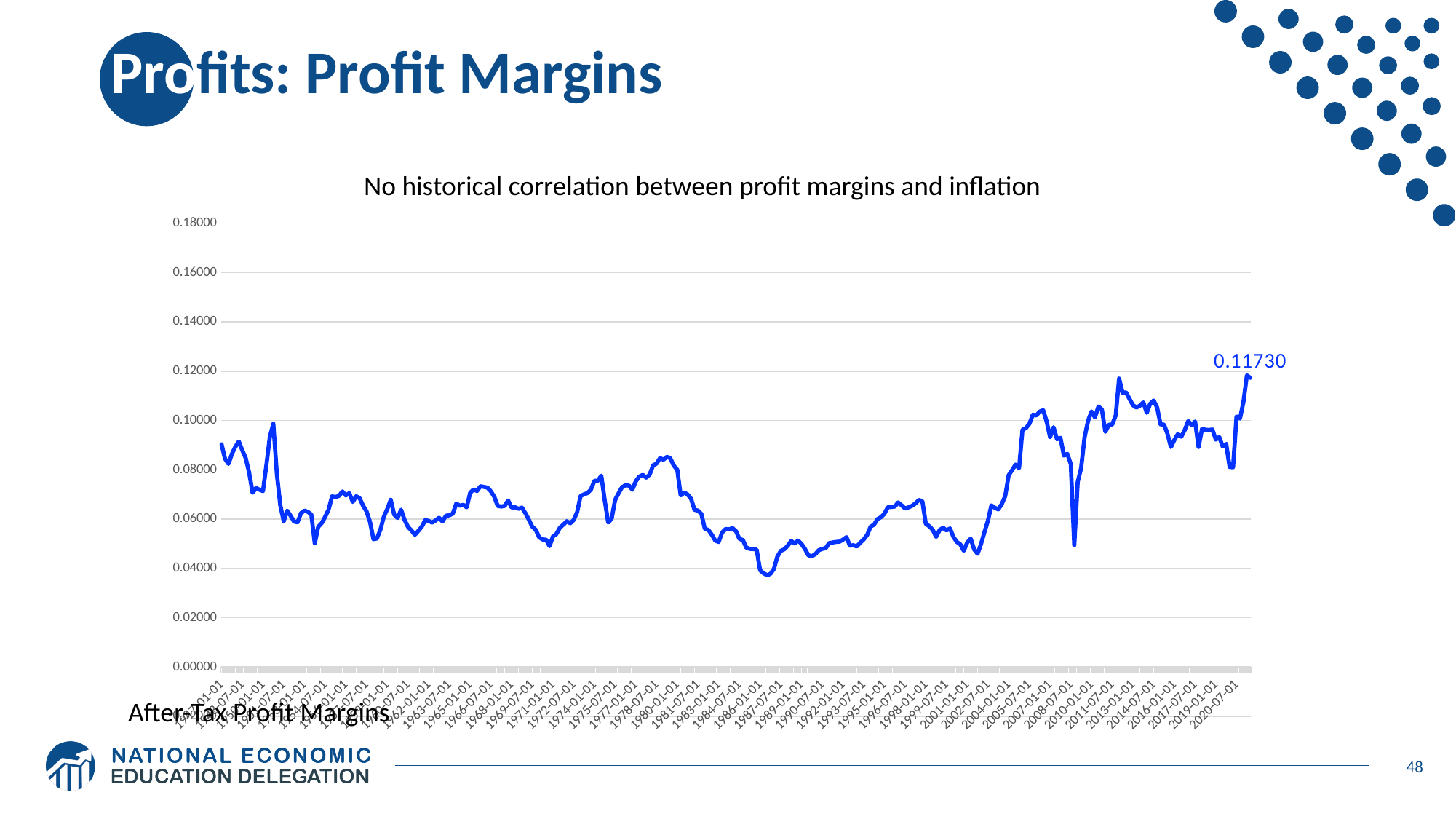
How many series are plotted on the chart? 1 Is the value at the start of the series (1951-01-01) greater or less than 0.06000? greater What is the highest tick value shown on the y axis? 0.18000 Is the lowest point of the line greater or less than 0.06000? less Is the value at 2020-07-01 larger or smaller than the value at 1951-01-01? larger Does the line ever reach above 0.14000 on the y axis? No What is the value shown by the data label at the end of the line (2020-07-01)? 0.11730 What is the title of the chart? No historical correlation between profit margins and inflation What kind of chart is shown on the slide? line chart Does the line rise or fall between 2019-07-01 and 2020-07-01? rise What series does the chart plot? After-Tax Profit Margins